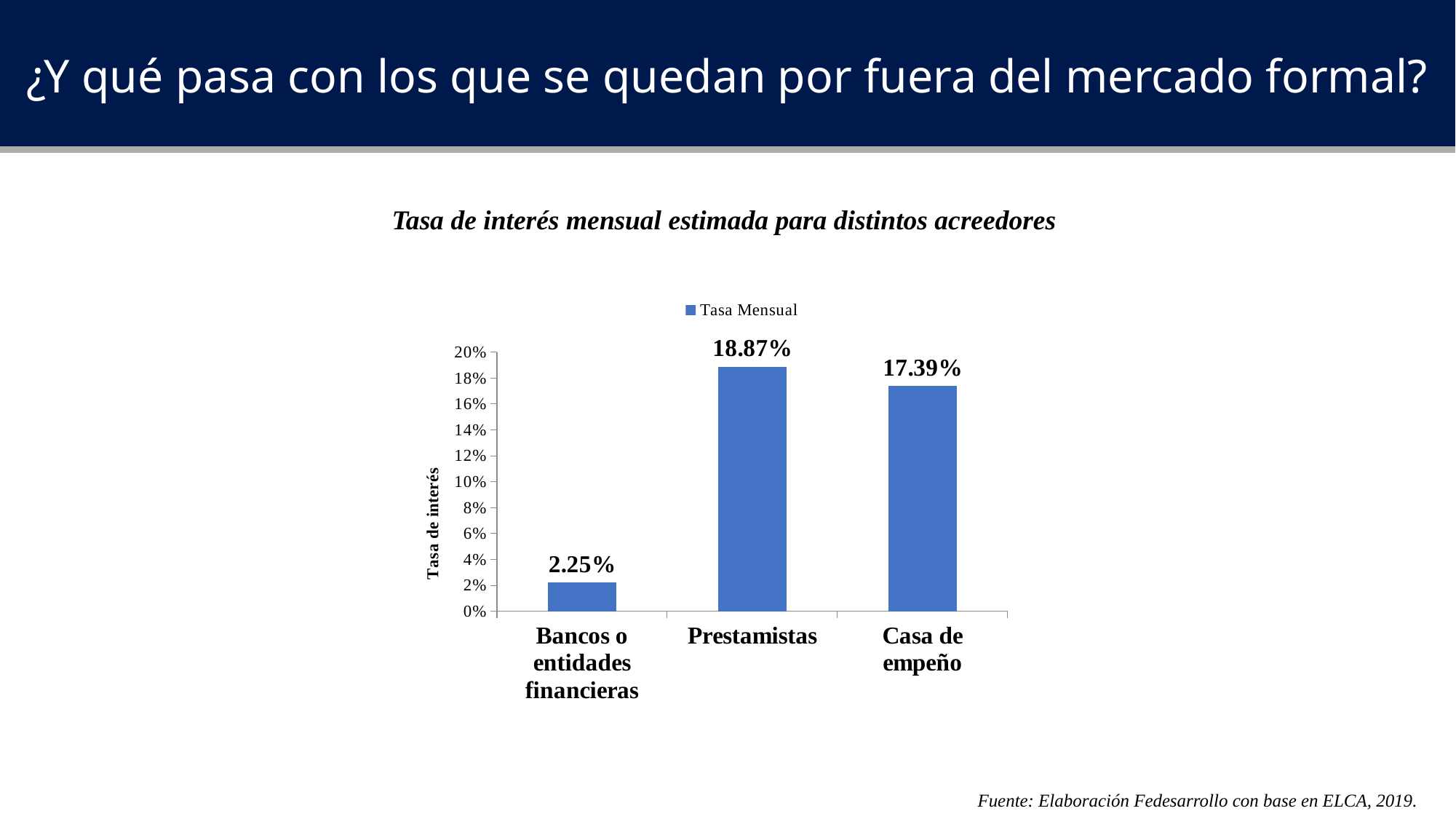
How many creditor categories are shown in the chart? 3 What is the difference between the monthly interest rate for Prestamistas and for Casa de empeño? 1.48% What is the monthly interest rate for Prestamistas? 18.87% What is the difference between the monthly interest rate for Casa de empeño and for Bancos o entidades financieras? 15.14% Is the value for Casa de empeño greater or less than 16%? greater What type of chart is shown on the slide? Bar chart Which has a higher monthly interest rate, Prestamistas or Casa de empeño? Prestamistas What is the monthly interest rate for Bancos o entidades financieras? 2.25% What is the title of the chart? Tasa de interés mensual estimada para distintos acreedores Which creditor has the highest monthly interest rate? Prestamistas What is the monthly interest rate for Casa de empeño? 17.39% Which creditor has the lowest monthly interest rate? Bancos o entidades financieras